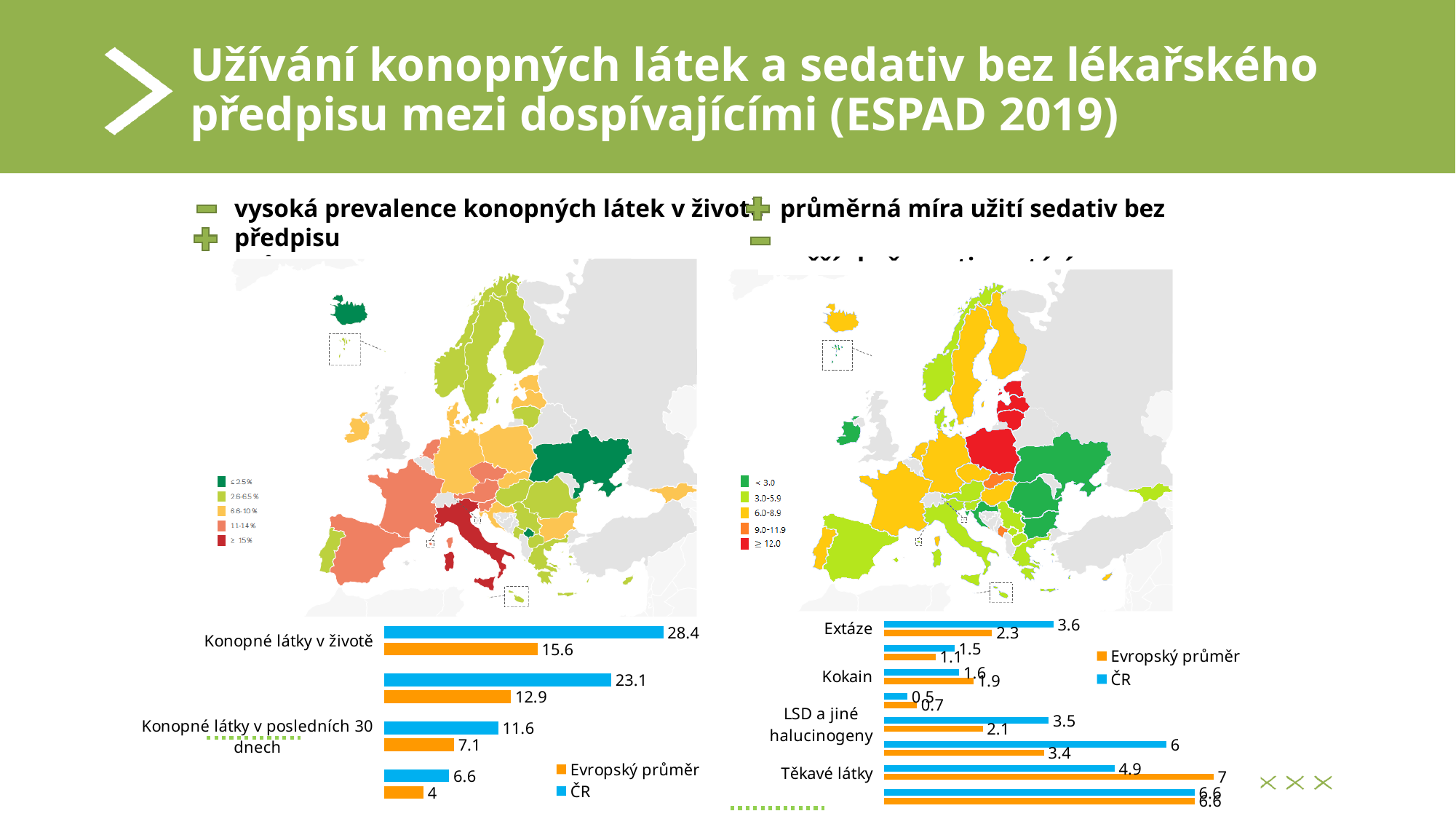
In the left bar chart, what is the difference between the ČR and Evropský průměr values for Konopné látky v životě? 12.8 In the right bar chart, which series has the larger value for Těkavé látky, ČR or Evropský průměr? Evropský průměr In the right bar chart, what is the difference between the ČR and Evropský průměr values for Extáze? 1.3 In the left bar chart, what is the ČR value for Konopné látky v životě? 28.4 In the left bar chart, what is the Evropský průměr value for Konopné látky v posledních 30 dnech? 7.1 In the left bar chart, what is the Evropský průměr value for Konopné látky v životě? 15.6 In the left bar chart, what is the ČR value for Konopné látky v posledních 30 dnech? 11.6 In the right bar chart, what is the Evropský průměr value for Kokain? 1.9 In the right bar chart, what is the ČR value for Extáze? 3.6 In the right bar chart, what is the Evropský průměr value for Těkavé látky? 7 How many series does the legend of the left bar chart list? 2 What kind of chart is shown at the bottom left of the slide? bar chart